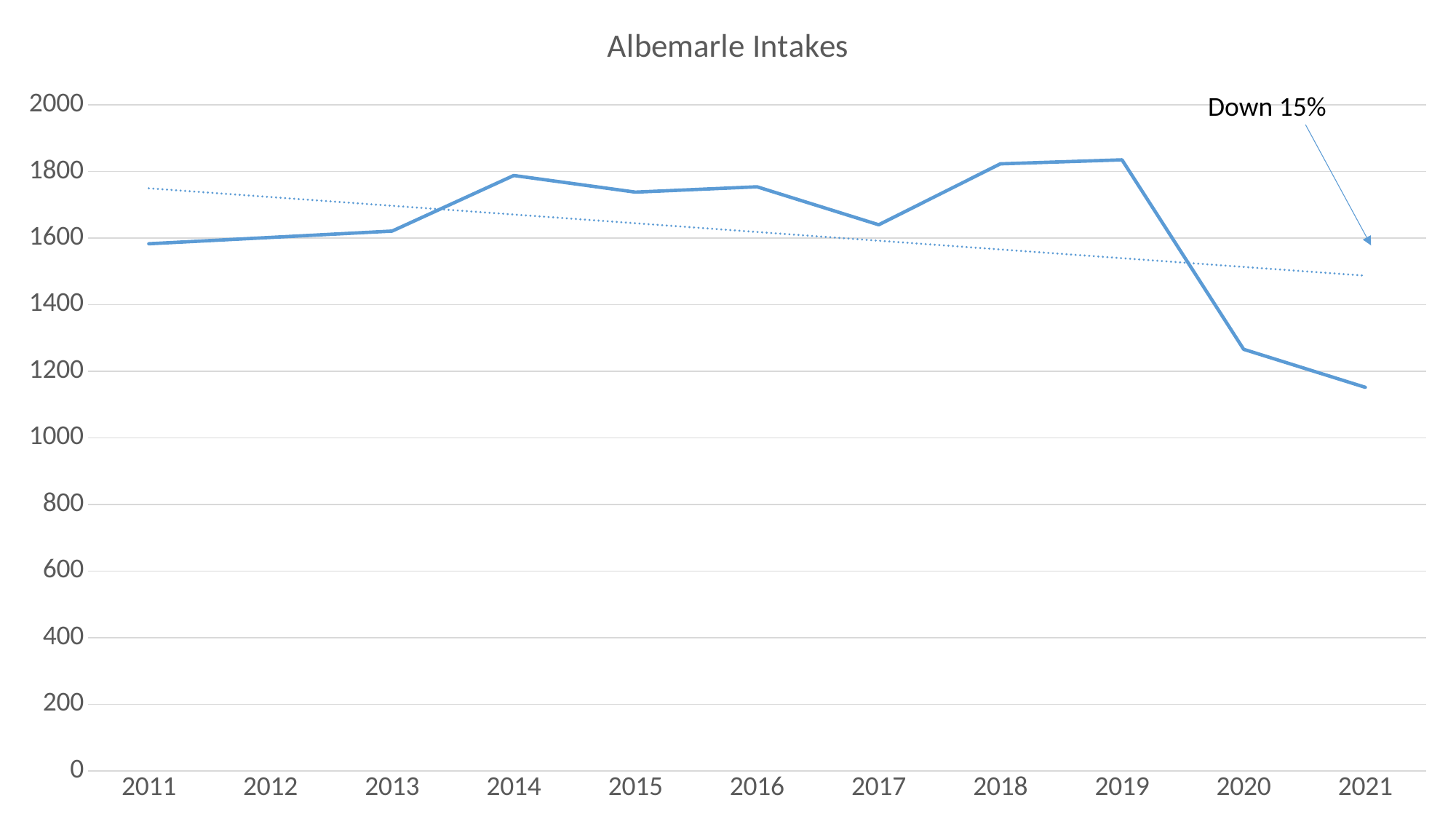
Is the value for 2021 greater or less than 1200? less How many years are plotted along the x axis? 11 What kind of chart is shown on the slide? line chart Do the values rise or fall from 2019 to 2021? fall Which year has the lowest intake value? 2021 Which year has the higher value, 2019 or 2020? 2019 Which year has the higher value, 2014 or 2017? 2014 What does the text annotation with the arrow on the chart say? Down 15% What is the title of the chart? Albemarle Intakes Is the value for 2020 greater or less than 1400? less Is the value for 2019 greater or less than 1800? greater